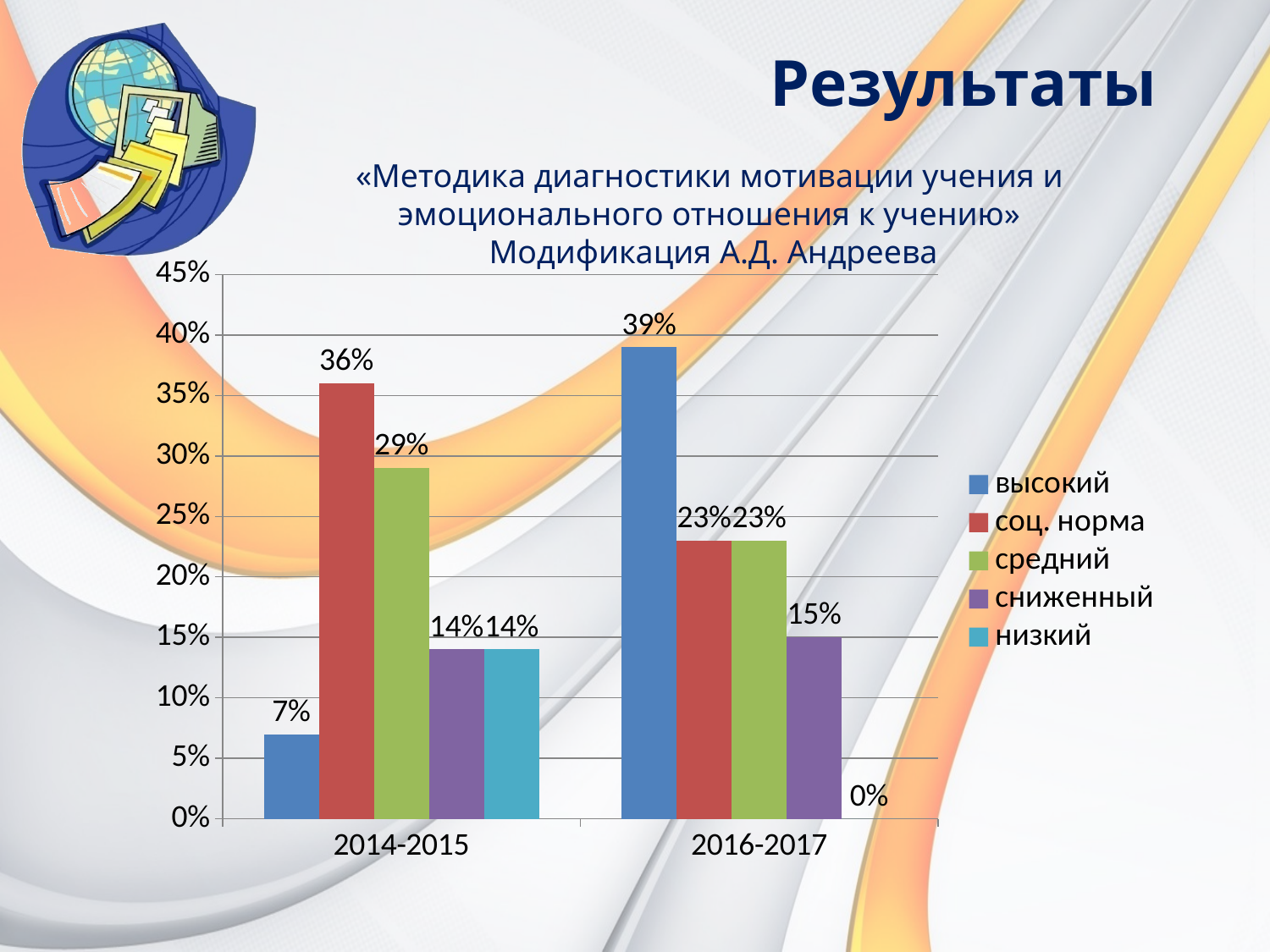
What is the difference between the высокий values for 2016-2017 and 2014-2015? 32% What is the value for высокий in 2014-2015? 7% Which series has the lowest value in 2016-2017? низкий What kind of chart is shown on the slide? bar chart How many series does the legend list? 5 How many categories are shown on the x axis? 2 What is the value for низкий in 2016-2017? 0% Which is larger: средний in 2014-2015 or средний in 2016-2017? средний in 2014-2015 What is the value for соц. норма in 2014-2015? 36% Does the value for сниженный rise or fall from 2014-2015 to 2016-2017? rise What is the value for высокий in 2016-2017? 39% Which series has the highest value in 2014-2015? соц. норма